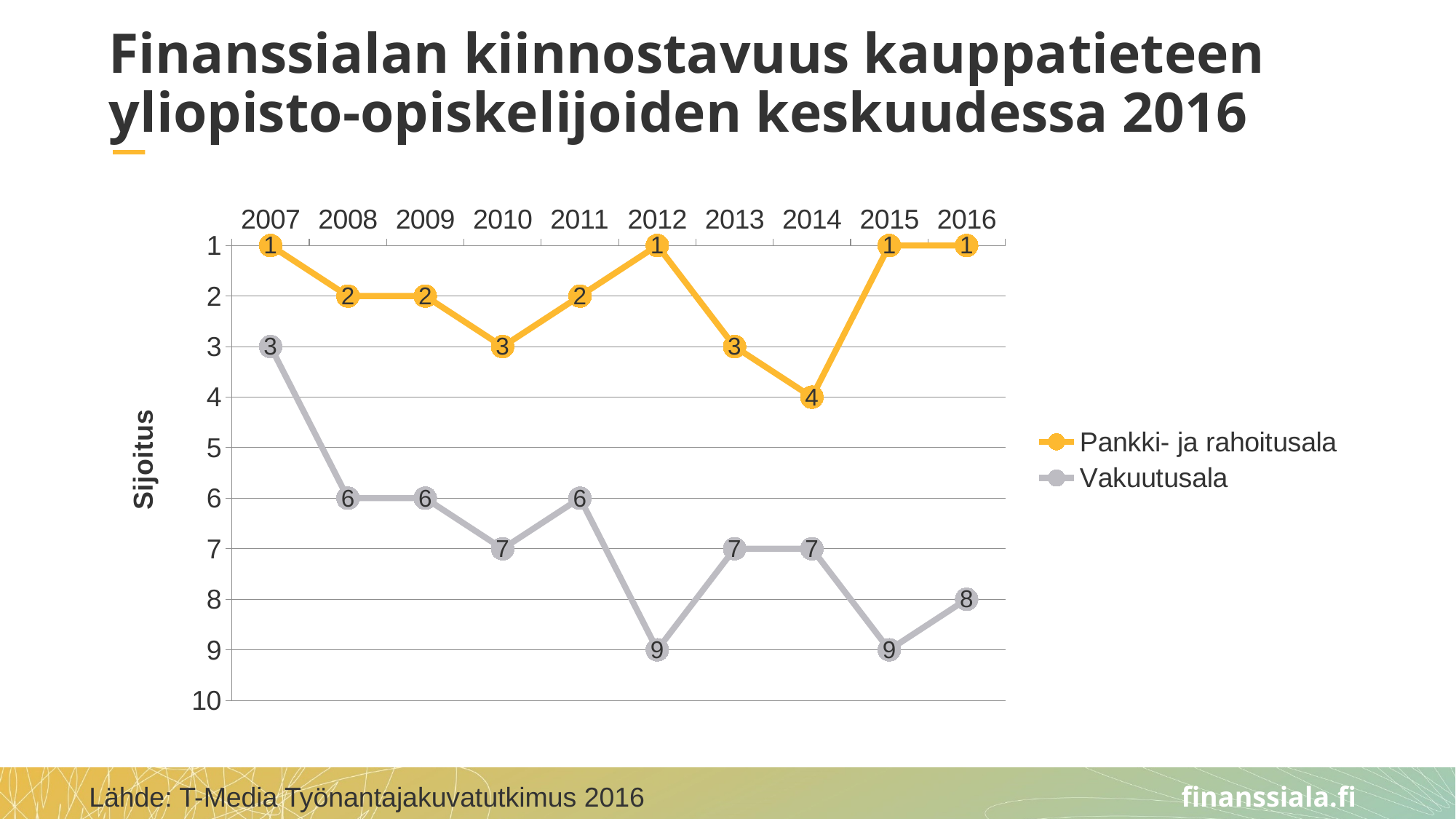
How many series does the legend list? 2 What is the value for Vakuutusala in 2016? 8 In which year does Pankki- ja rahoitusala have its largest value (worst ranking)? 2014 Which series has the larger value in 2008, Pankki- ja rahoitusala or Vakuutusala? Vakuutusala What type of chart is shown on the slide? line chart What is the value for Pankki- ja rahoitusala in 2014? 4 What is the value for Vakuutusala in 2012? 9 What is the value for Pankki- ja rahoitusala in 2010? 3 How many years are plotted along the x axis? 10 What is the difference between the Vakuutusala and Pankki- ja rahoitusala values in 2012? 8 In which year does Vakuutusala have its smallest value (best ranking)? 2007 What is the label of the y axis? Sijoitus